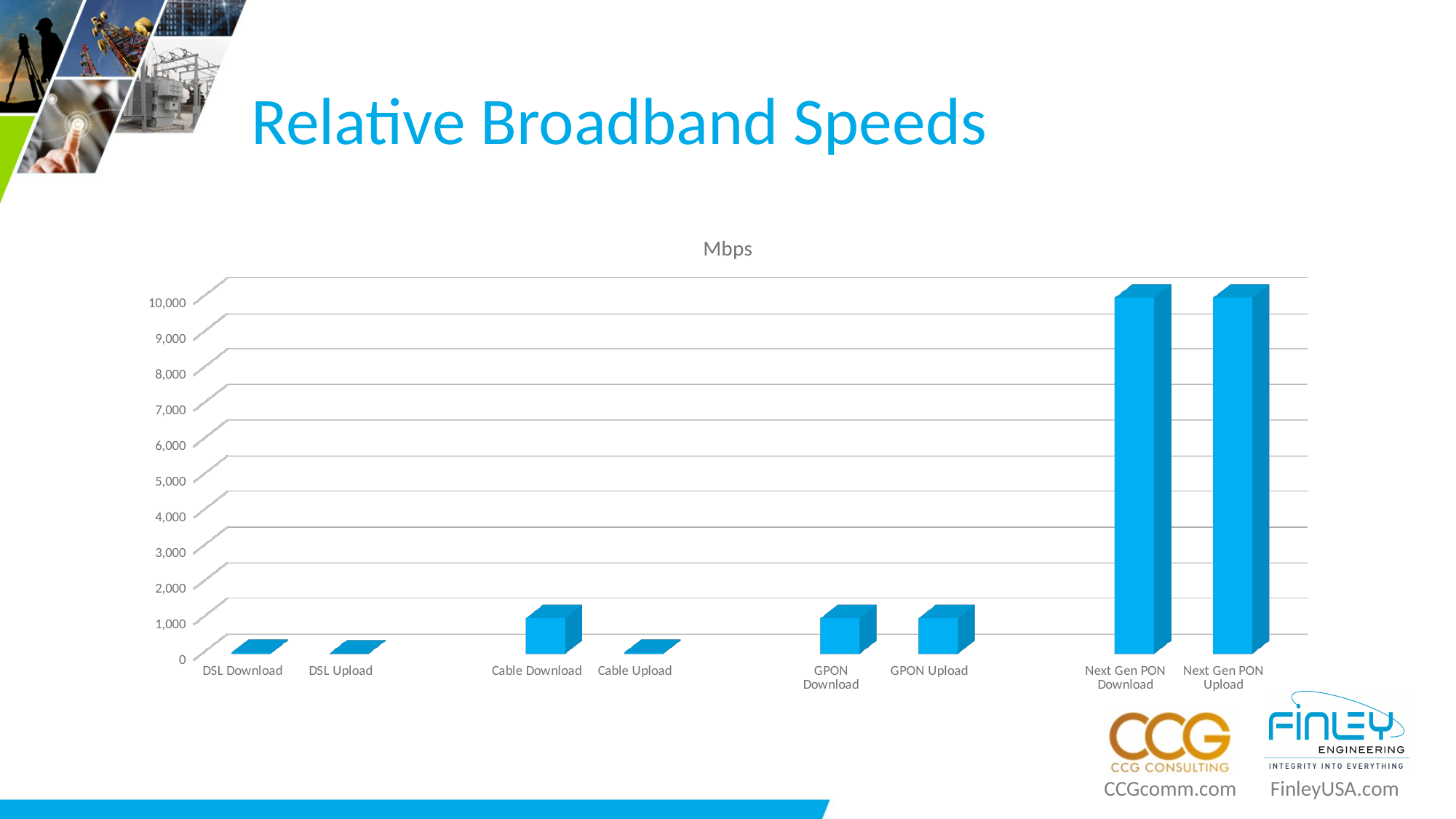
Which is larger, GPON Upload or DSL Upload? GPON Upload Is the value for DSL Download greater or less than 1,000? less How many categories are plotted on the chart? 8 Is the value for Next Gen PON Download greater or less than 9,000? greater Which is larger, Next Gen PON Download or GPON Download? Next Gen PON Download What kind of chart is shown on the slide? bar chart Is the value for GPON Upload greater or less than 3,000? less What is the title of the chart? Mbps What colour are the bars in the chart? blue Which is larger, Cable Download or Cable Upload? Cable Download